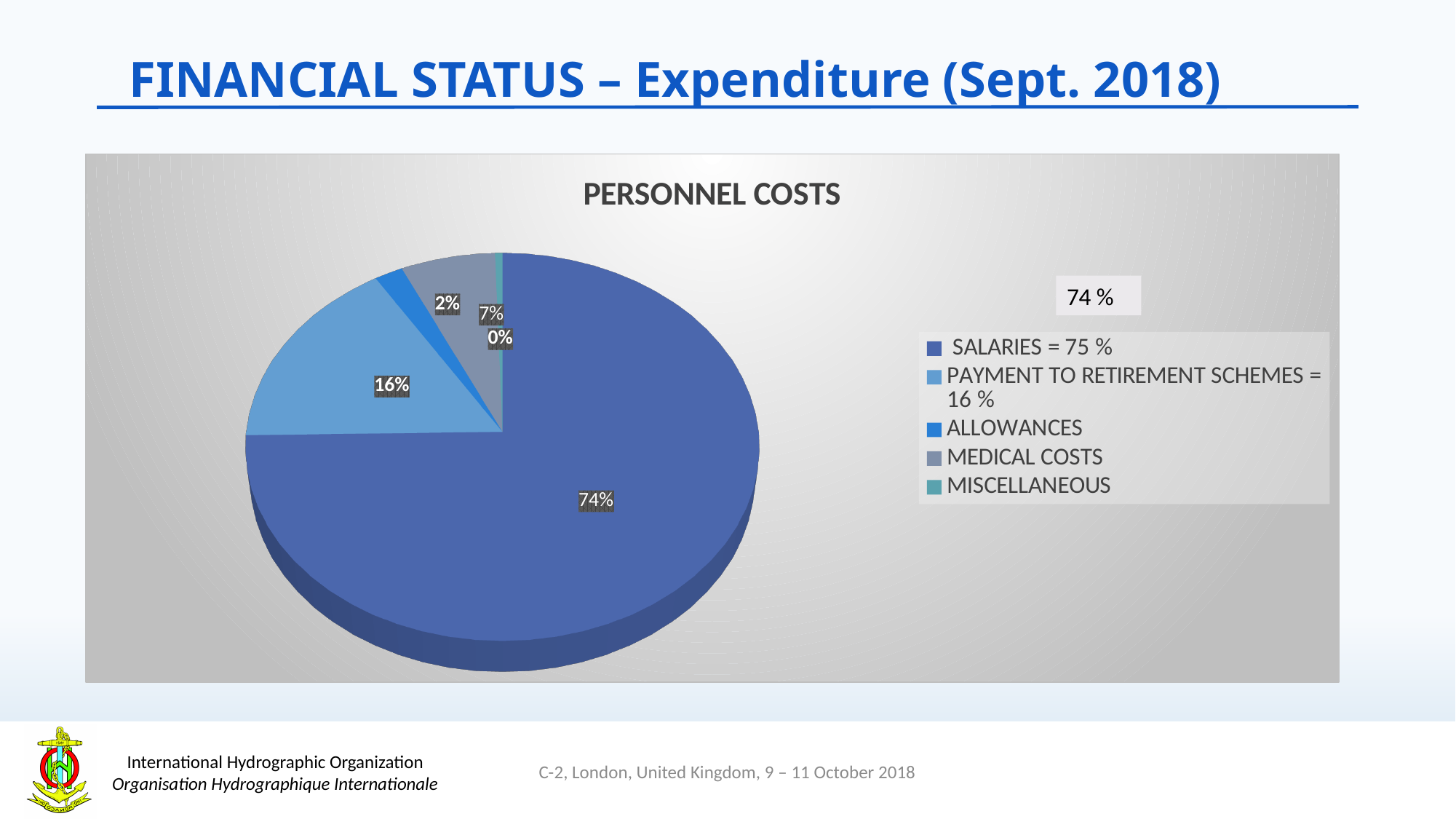
What percentage does the legend state for SALARIES? 75 % What percentage is labelled on the ALLOWANCES slice? 2% What percentage is labelled on the MEDICAL COSTS slice? 7% Which category has the smallest share of the PERSONNEL COSTS pie? MISCELLANEOUS What percentage is labelled on the MISCELLANEOUS slice? 0% By how many percentage points does the PAYMENT TO RETIREMENT SCHEMES slice exceed the MEDICAL COSTS slice? 9 percentage points What percentage is labelled on the PAYMENT TO RETIREMENT SCHEMES slice? 16% What is the title of the pie chart? PERSONNEL COSTS What type of chart is shown on the slide? pie chart Which is larger, the MEDICAL COSTS slice or the ALLOWANCES slice? MEDICAL COSTS Which category has the largest share of the PERSONNEL COSTS pie? SALARIES How many slices (categories) does the PERSONNEL COSTS pie chart have? 5